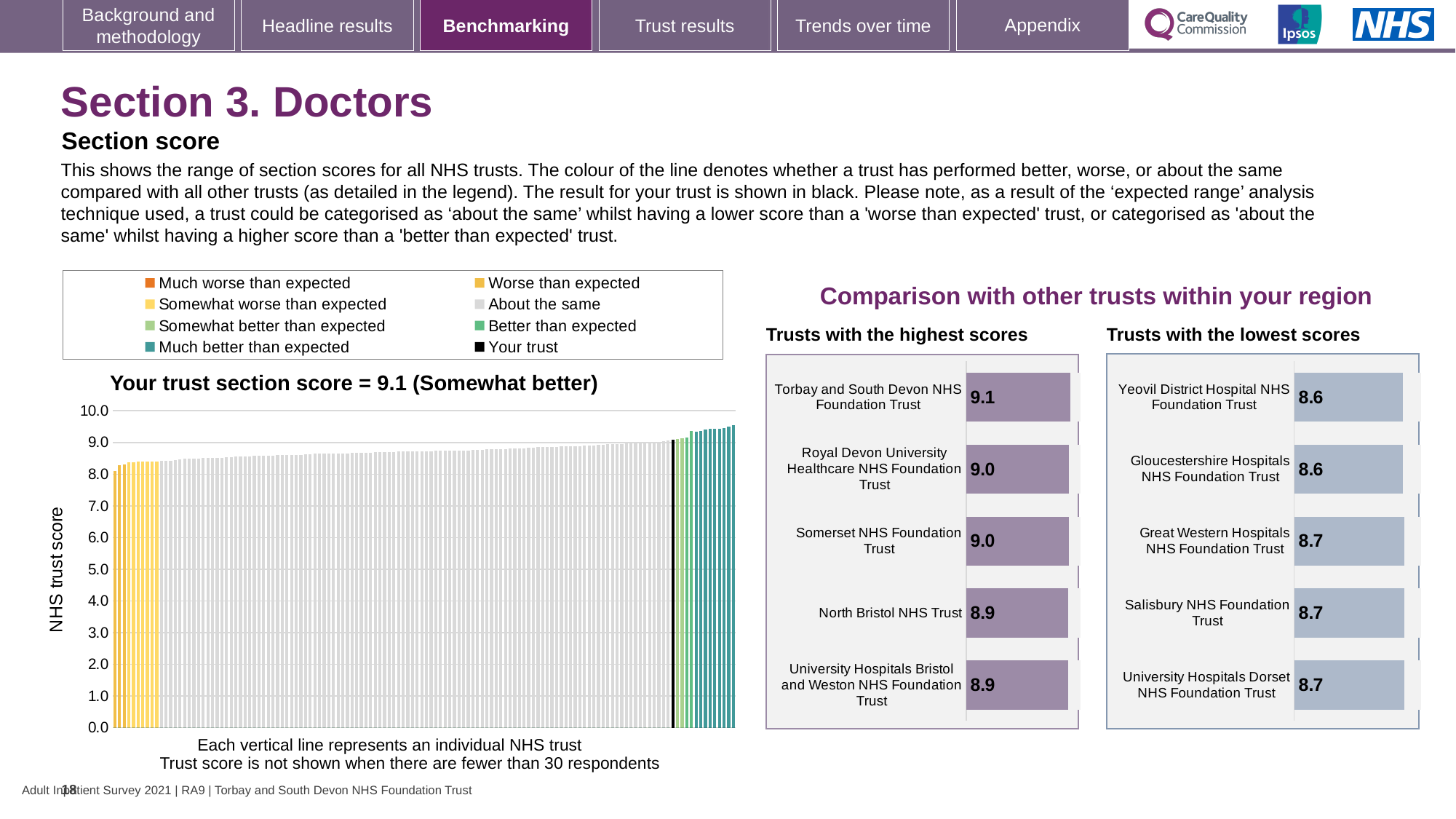
In the 'Trusts with the highest scores' chart, what is the score for Torbay and South Devon NHS Foundation Trust? 9.1 In the 'Your trust section score' chart, do the trust scores rise or fall from left to right along the x axis? rise In the 'Trusts with the lowest scores' chart, how many trusts are shown? 5 What kind of chart is the 'Your trust section score' chart? bar chart In the 'Trusts with the highest scores' chart, what is the difference between the scores of Torbay and South Devon NHS Foundation Trust and North Bristol NHS Trust? 0.2 In the 'Your trust section score' chart, what is the label on the vertical axis? NHS trust score In the 'Trusts with the highest scores' chart, how many trusts are shown? 5 How many entries does the legend above the 'Your trust section score' chart list? 8 In the 'Trusts with the highest scores' chart, which trust has the highest score? Torbay and South Devon NHS Foundation Trust In the 'Trusts with the lowest scores' chart, what is the score for Yeovil District Hospital NHS Foundation Trust? 8.6 In the 'Trusts with the lowest scores' chart, which is larger: the score for Great Western Hospitals NHS Foundation Trust or the score for Gloucestershire Hospitals NHS Foundation Trust? Great Western Hospitals NHS Foundation Trust In the 'Your trust section score' chart, what is the section score for your trust? 9.1